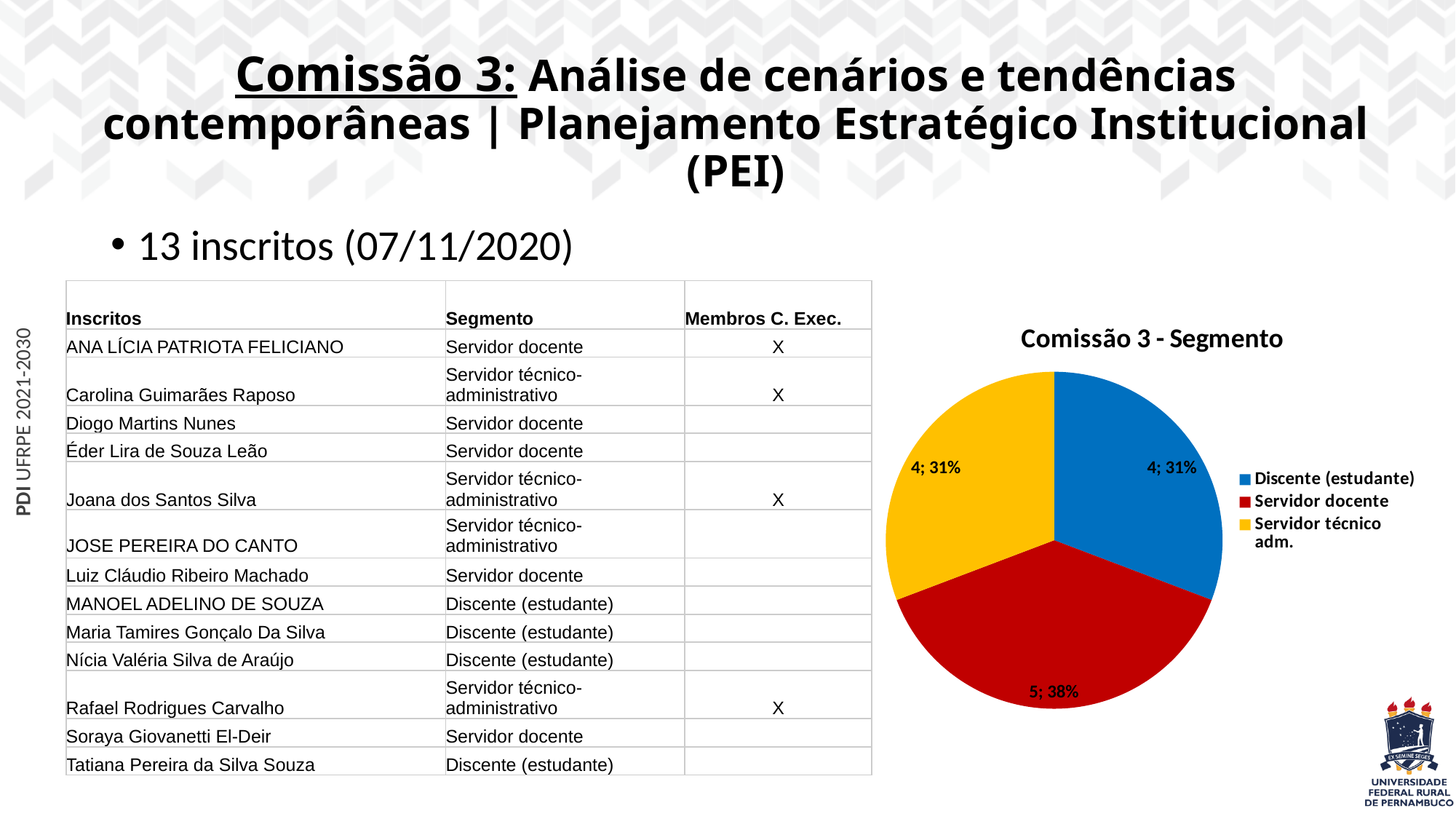
How many slices does the pie chart have? 3 What colour is the Servidor docente slice in the pie chart? red Which is larger, the slice for Servidor docente or the slice for Servidor técnico adm.? Servidor docente What is the count shown for Discente (estudante) in the pie chart? 4 How many entries does the chart legend list? 3 What kind of chart is shown on the slide? pie chart What is the difference between the count for Servidor docente and the count for Discente (estudante)? 1 What share of the pie does Servidor docente represent? 38% Which segment has the largest slice in the pie chart? Servidor docente What share of the pie does Servidor técnico adm. represent? 31% What is the count shown for Servidor docente in the pie chart? 5 What is the title of the chart? Comissão 3 - Segmento